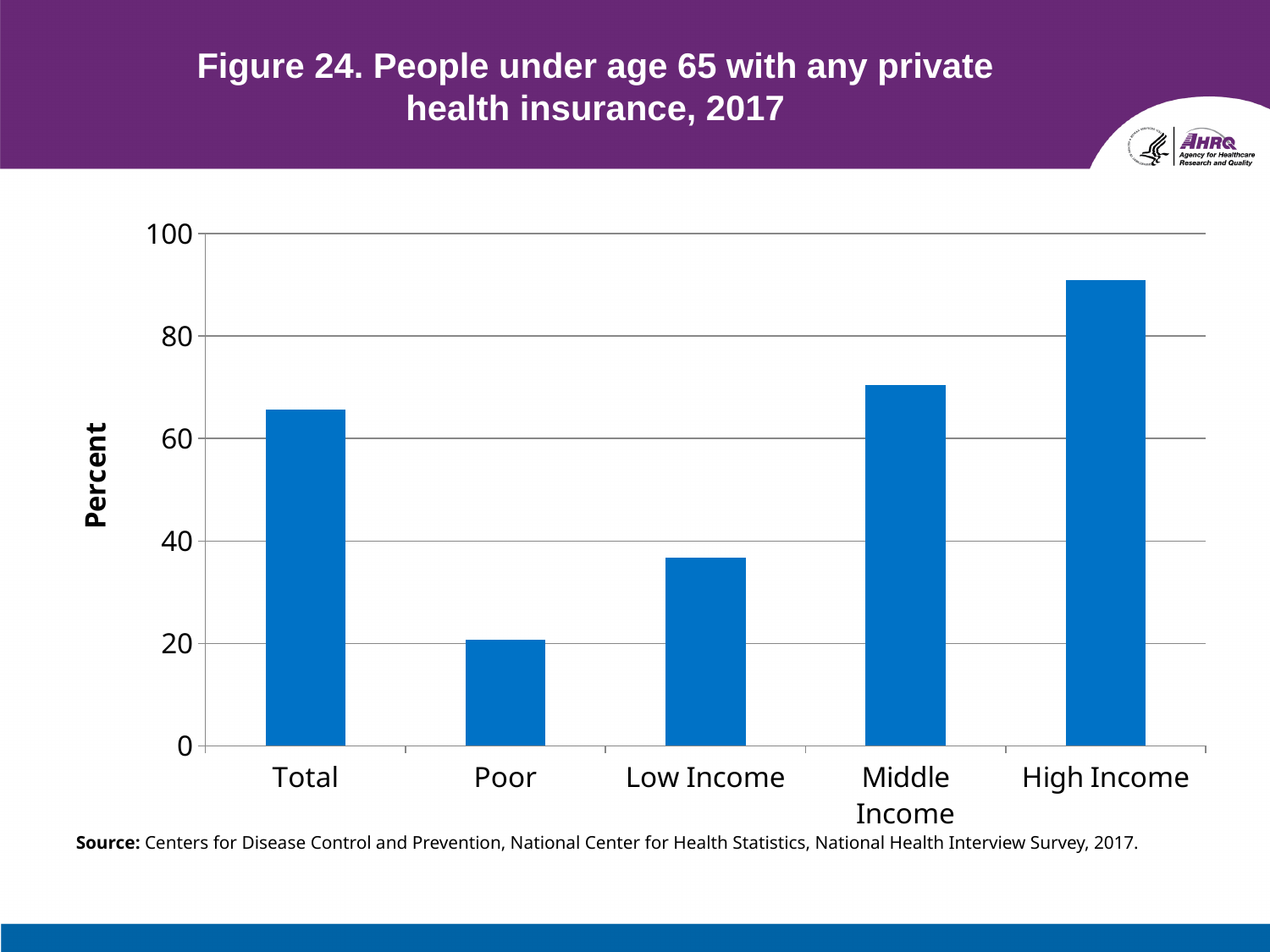
Is the value for High Income greater or less than 80? greater Which is larger, the value for Total or the value for Poor? Total What kind of chart is shown on the slide? bar chart Is the value for Poor greater or less than 40? less What is the label on the y axis? Percent How many categories are shown on the x axis? 5 Is the value for Total greater or less than 60? greater Which category has the lowest percentage? Poor Which category has the highest percentage? High Income Which is larger, the value for Middle Income or the value for Low Income? Middle Income